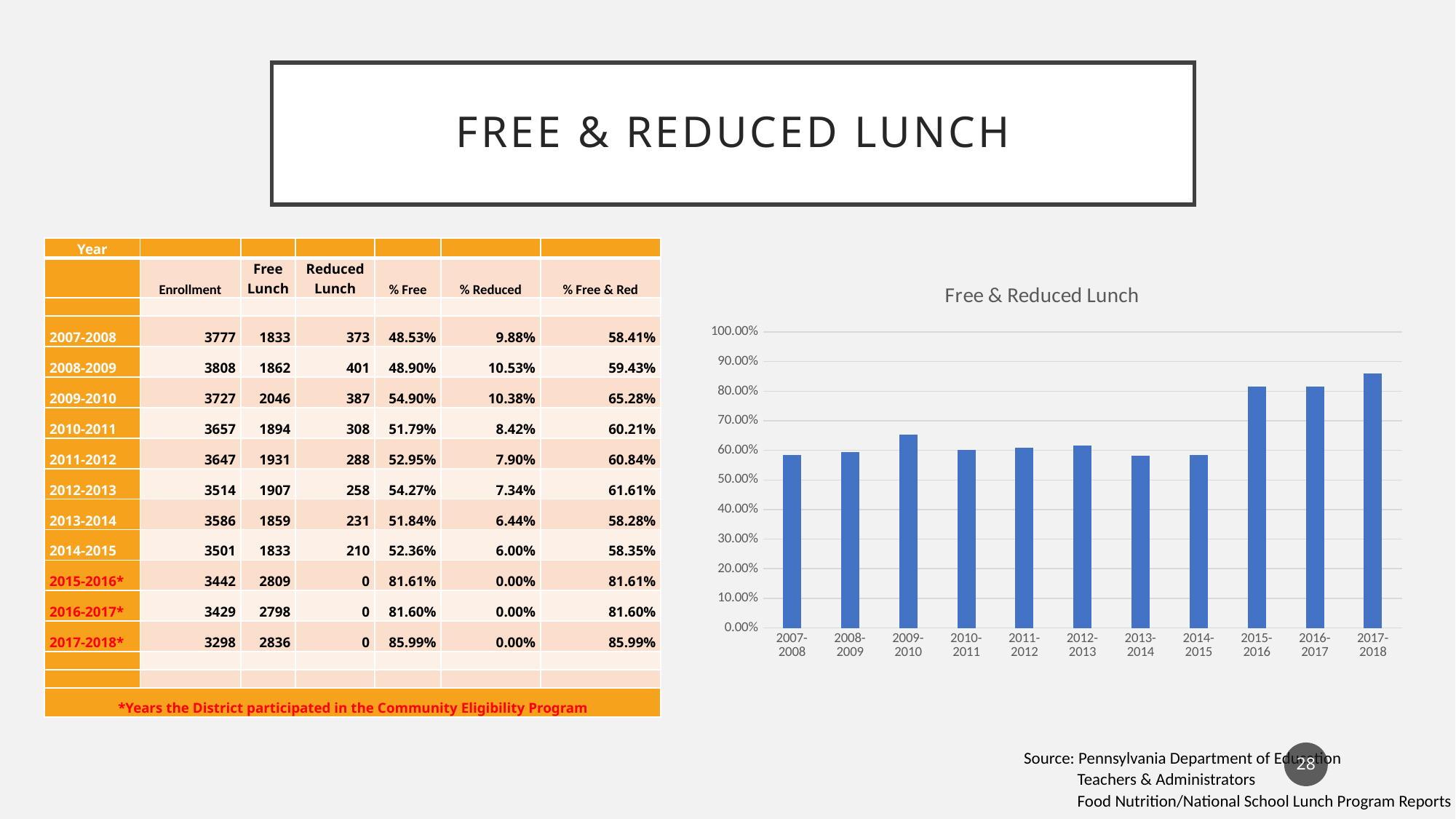
Which is larger, the value for 2009-2010 or the value for 2010-2011? 2009-2010 Is the value for 2017-2018 greater or less than 80.00%? greater According to the slide, what is the % Free & Red value plotted for 2017-2018? 85.99% Which is larger, the value for 2015-2016 or the value for 2014-2015? 2015-2016 What kind of chart is shown on the slide? bar chart How many school years are plotted in the chart? 11 Is the value for 2009-2010 greater or less than 60.00%? greater According to the slide, what is the % Free & Red value plotted for 2007-2008? 58.41% Which school year has the highest bar in the chart? 2017-2018 What is the title of the chart? Free & Reduced Lunch Do the bars rise or fall from 2014-2015 to 2017-2018? rise Is the value for 2013-2014 greater or less than 60.00%? less